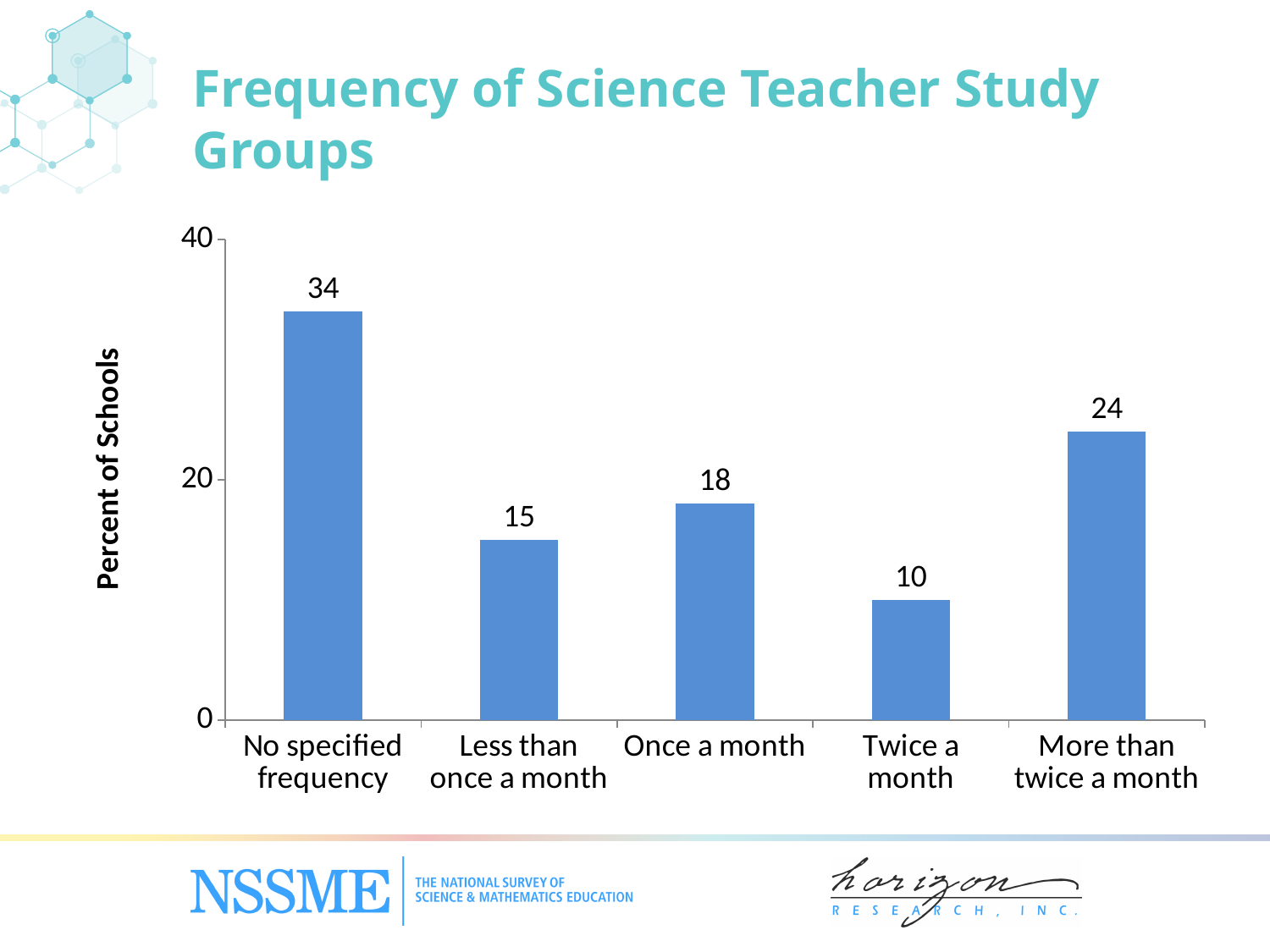
Is the value for 'More than twice a month' greater or less than 20? greater How many categories are shown on the x axis? 5 What is the difference between the values for 'Once a month' and 'Less than once a month'? 3 What is the label of the vertical axis? Percent of Schools What percent of schools have science teacher study groups with no specified frequency? 34 Which is larger, the value for 'Once a month' or the value for 'Twice a month'? Once a month Which category has the lowest percent of schools? Twice a month What is the value for 'More than twice a month'? 24 Which category has the highest percent of schools? No specified frequency What is the value for 'Twice a month'? 10 What kind of chart is shown on the slide? Bar chart What is the difference between the values for 'No specified frequency' and 'More than twice a month'? 10